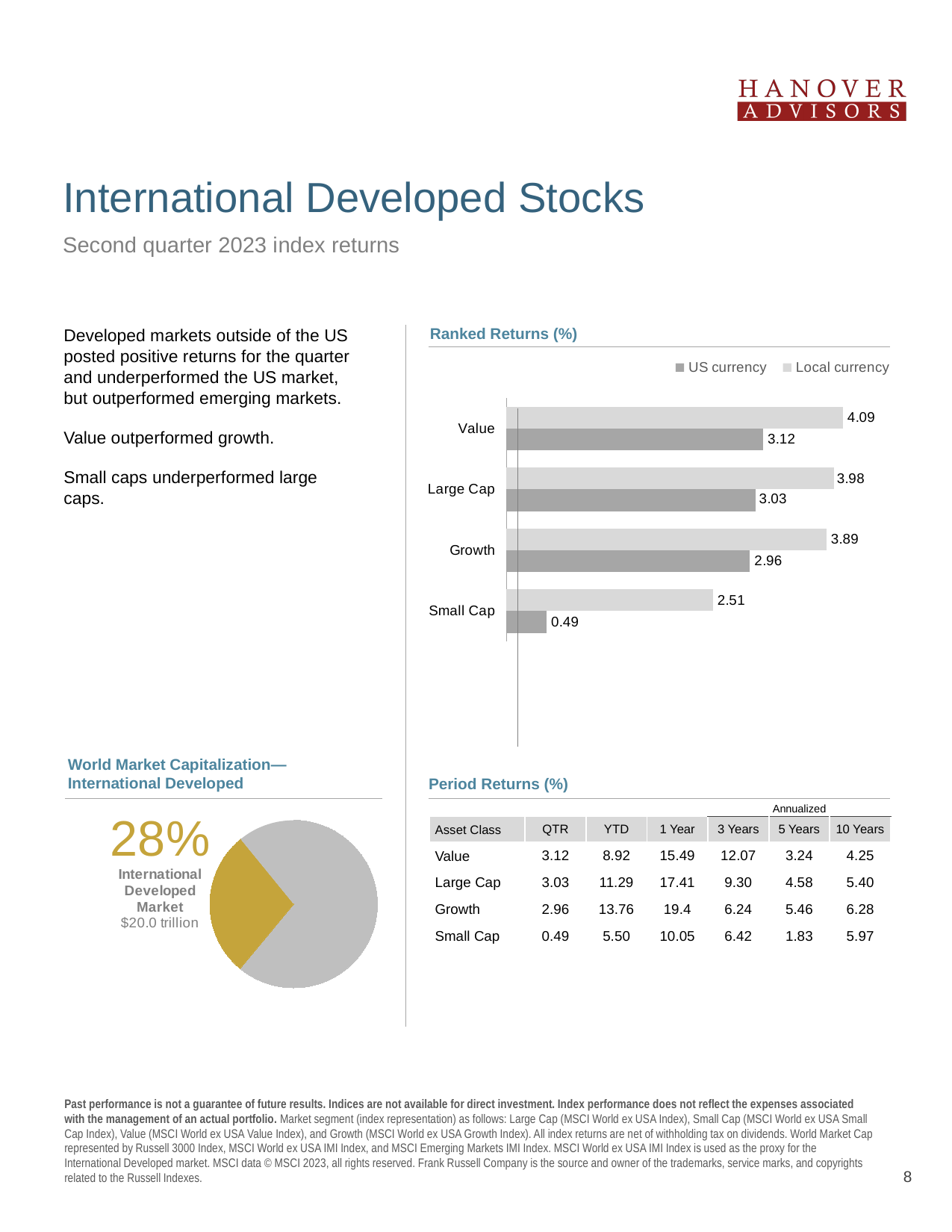
How many categories are shown in the Ranked Returns (%) chart? 4 In the Ranked Returns (%) chart, what is the Local currency return for Small Cap? 2.51 In the Ranked Returns (%) chart, which category has the highest Local currency return? Value What kind of chart is the Ranked Returns (%) chart? Bar chart In the Ranked Returns (%) chart, what is the difference between the Local currency and US currency returns for Small Cap? 2.02 In the World Market Capitalization—International Developed pie chart, what dollar value is shown for the International Developed Market? $20.0 trillion In the Ranked Returns (%) chart, what is the Local currency return for Growth? 3.89 In the Ranked Returns (%) chart, what is the US currency return for Value? 3.12 In the Ranked Returns (%) chart, which is larger: the US currency return for Large Cap or the US currency return for Growth? Large Cap In the World Market Capitalization—International Developed pie chart, what share does the International Developed Market represent? 28% In the Ranked Returns (%) chart, which category has the lowest US currency return? Small Cap How many series does the legend of the Ranked Returns (%) chart list? 2